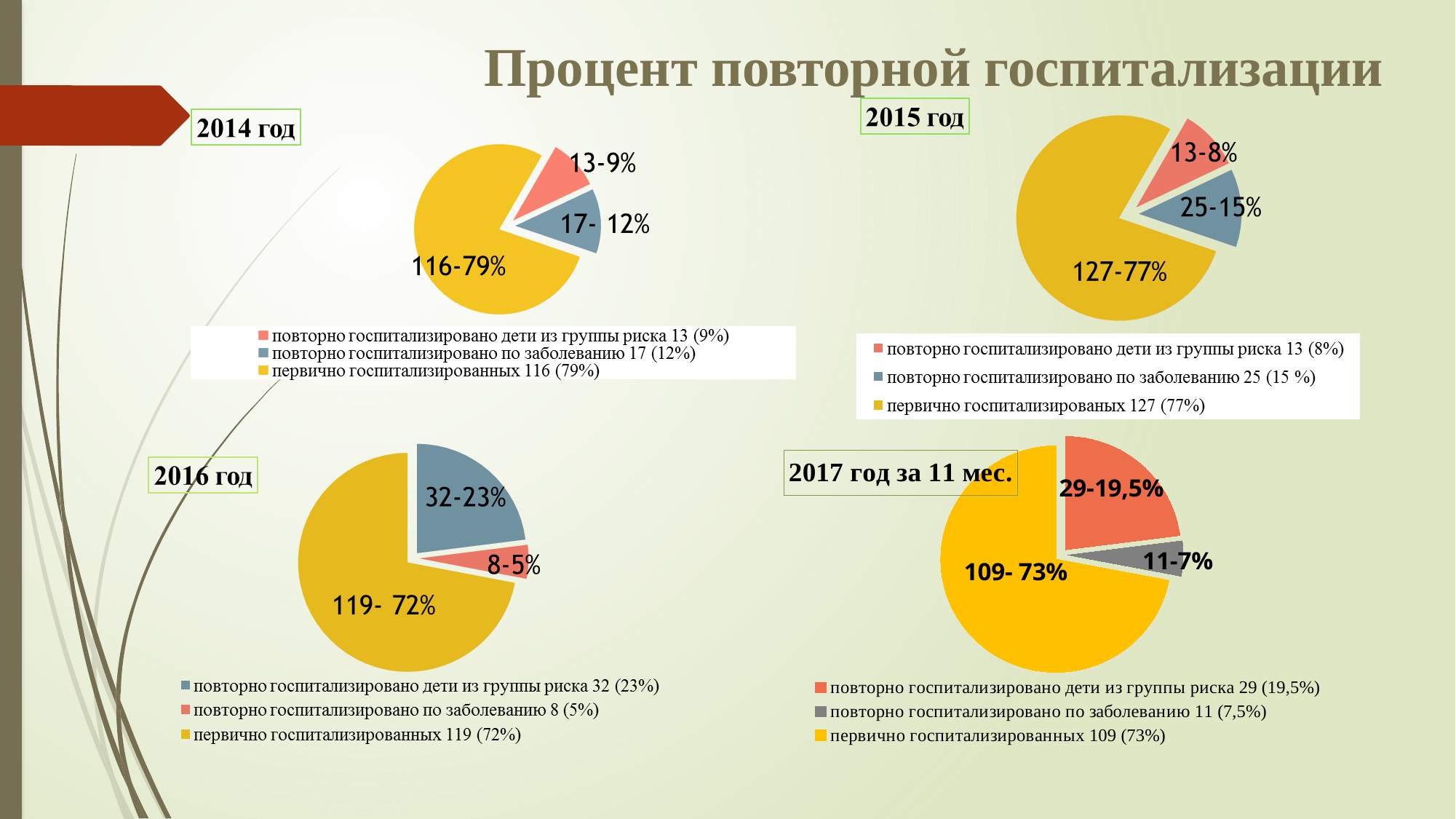
How many pie charts are shown on the slide? 4 In the 2016 год chart, which category has the smallest slice? повторно госпитализировано по заболеванию In the 2016 год chart, which category has the largest slice? первично госпитализированных How many slices does the 2017 год за 11 мес. pie chart have? 3 In the 2014 год chart, how many children were первично госпитализированных? 116 In the 2014 год chart, which is larger: повторно госпитализировано дети из группы риска or повторно госпитализировано по заболеванию? повторно госпитализировано по заболеванию What kind of chart is used for the 2014 год data? pie chart In the 2015 год chart, what is the difference between the number of первично госпитализированых (127) and повторно госпитализировано по заболеванию (25)? 102 In the 2015 год chart, what percentage is shown for повторно госпитализировано по заболеванию? 15% In the 2017 год за 11 мес. chart, what share of the pie is первично госпитализированных? 73% In the 2016 год chart, how many children were повторно госпитализировано дети из группы риска? 32 In the 2014 год chart, what is the total number of children across all three slices (13, 17 and 116)? 146